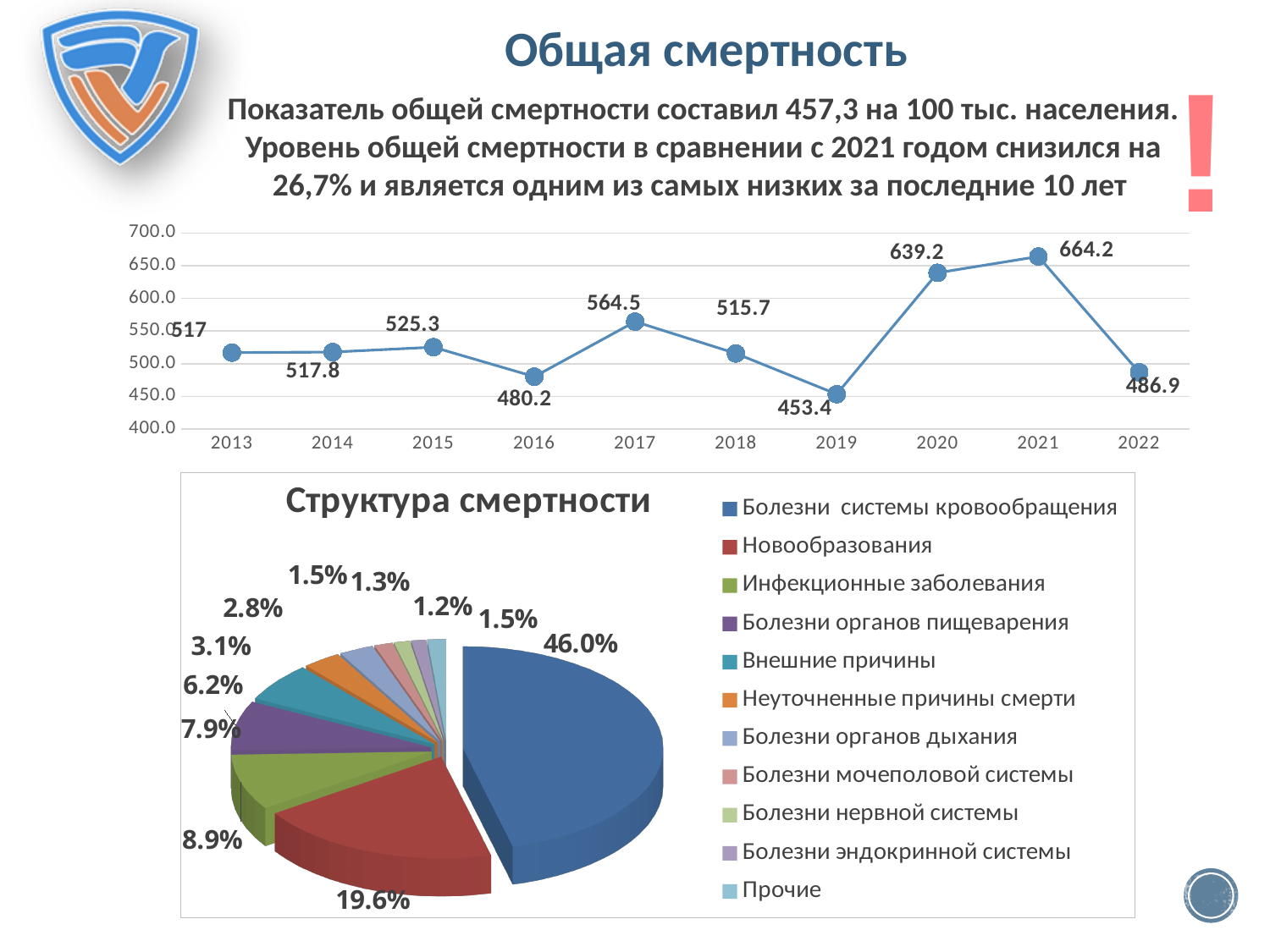
In the top line chart, how many years are plotted on the x axis? 10 In the pie chart 'Структура смертности', what share does 'Новообразования' have? 19.6% In the top line chart, does the value rise or fall from 2021 to 2022? fall In the top line chart, what is the difference between the values for 2021 and 2022? 177.3 In the pie chart 'Структура смертности', how many categories does the legend list? 11 In the top line chart, what is the value for 2019? 453.4 In the top line chart, which year has the highest value? 2021 In the pie chart 'Структура смертности', what share does 'Болезни системы кровообращения' have? 46.0% In the top line chart, which year has the lowest value? 2019 In the top line chart, what is the value for 2021? 664.2 What kind of chart is the chart titled 'Структура смертности'? pie chart In the top line chart, which is larger, the value for 2017 or the value for 2018? 2017